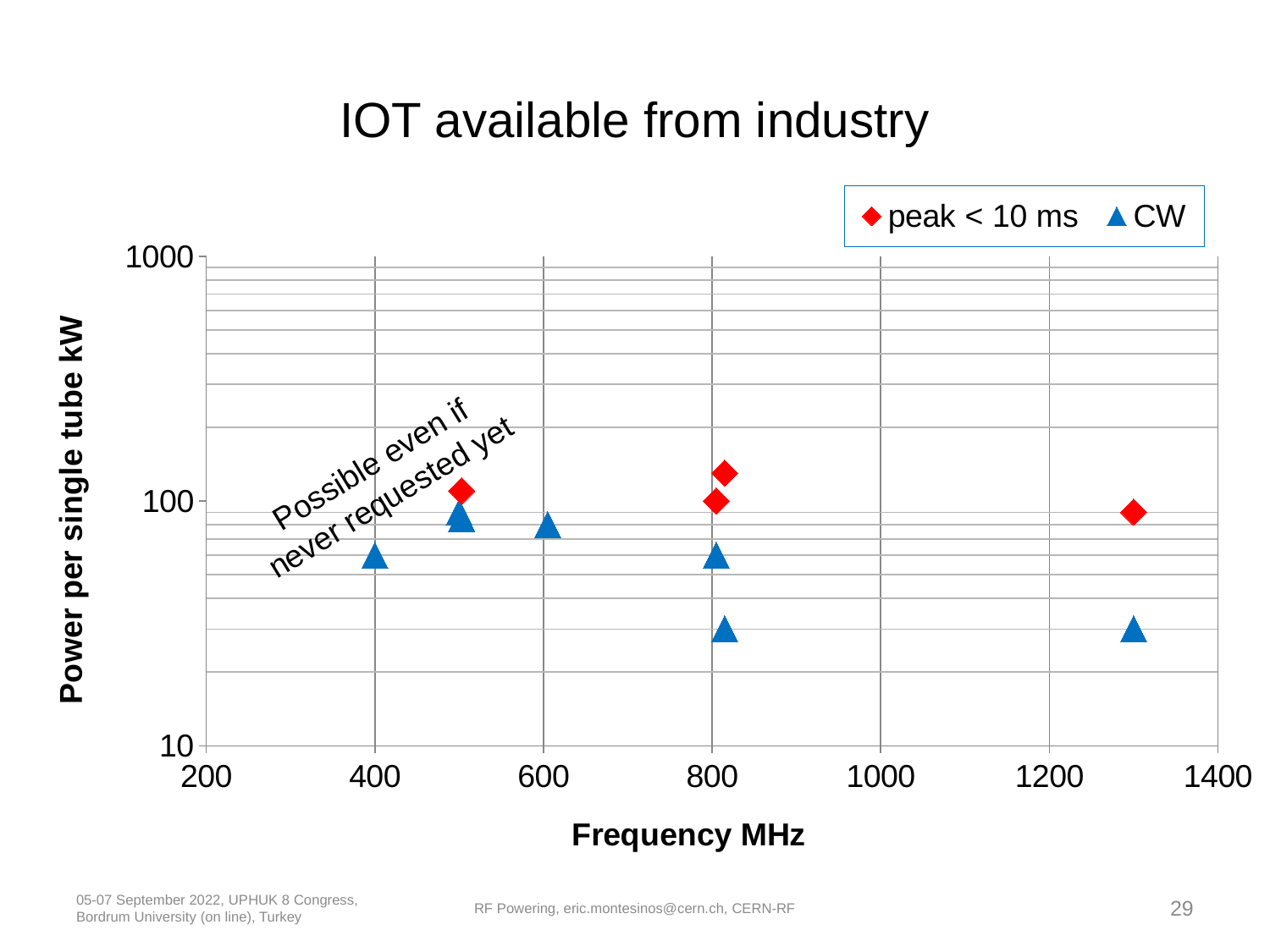
What is the title of the chart? IOT available from industry Which series contains the highest plotted point on the chart? peak < 10 ms How many series does the legend list? 2 What are the two series named in the legend? peak < 10 ms and CW What kind of chart is shown on the slide? Scatter chart At about 500 MHz, which series has the higher power value, peak < 10 ms or CW? peak < 10 ms How many blue triangle (CW) points are plotted? 7 Which series contains the lowest plotted points on the chart? CW At about 1300 MHz, which series has the higher power value, peak < 10 ms or CW? peak < 10 ms How many red diamond (peak < 10 ms) points are plotted? 4 Is the power value of the CW point at about 400 MHz greater or less than 100 kW? less Is the power value of the highest peak < 10 ms point near 800 MHz greater or less than 100 kW? greater